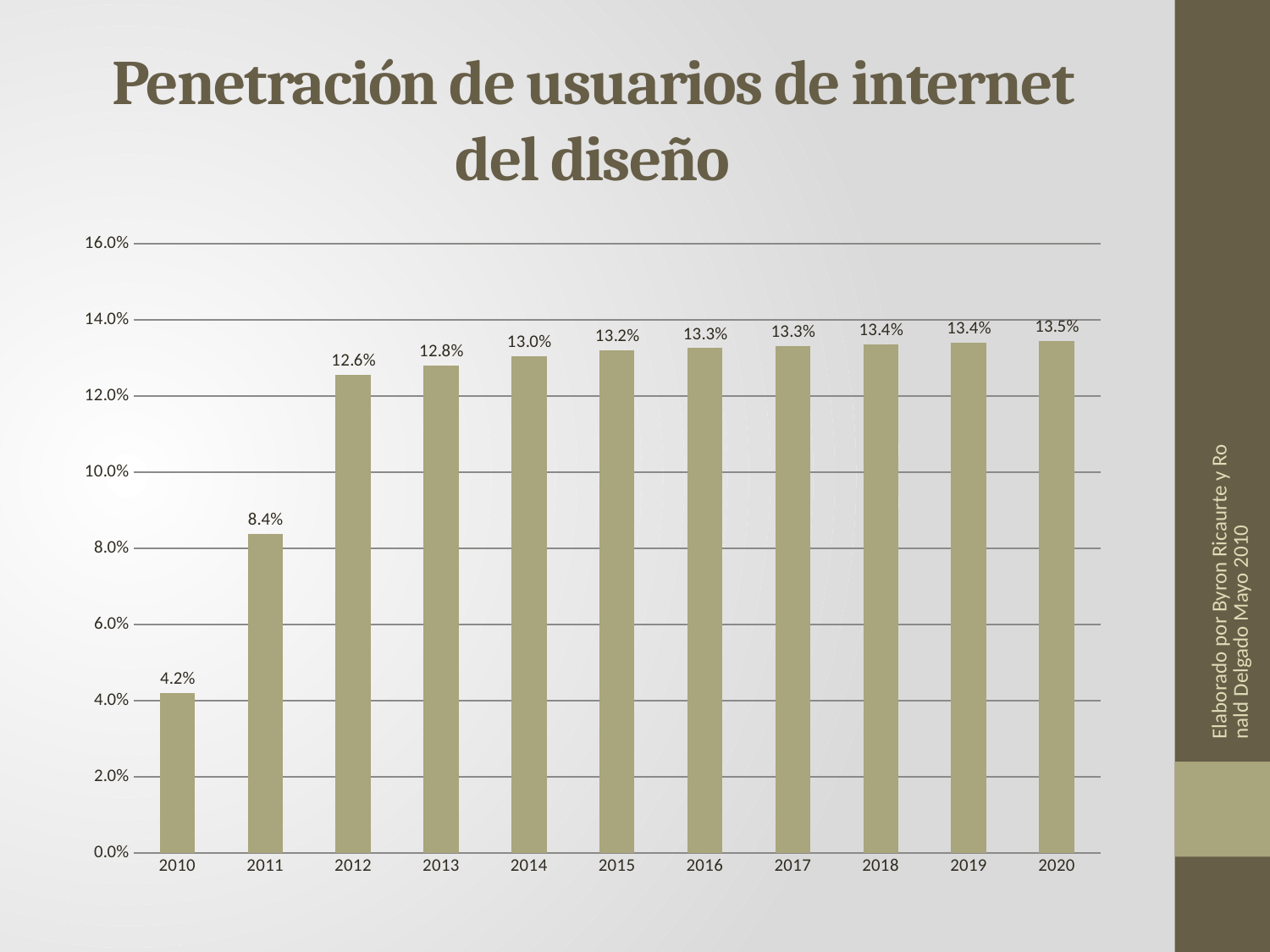
Do the values rise or fall from 2010 to 2020? rise Which year has the lowest value? 2010 Is the value for 2011 greater or less than 10.0%? less Which is larger, the value for 2013 or the value for 2011? 2013 What is the value for 2010? 4.2% How many years are shown on the x axis? 11 What is the difference between the values for 2011 and 2010? 4.2% Which year has the highest value? 2020 What is the value for 2020? 13.5% What is the difference between the values for 2012 and 2011? 4.2% What kind of chart is shown on the slide? bar chart What is the value for 2014? 13.0%